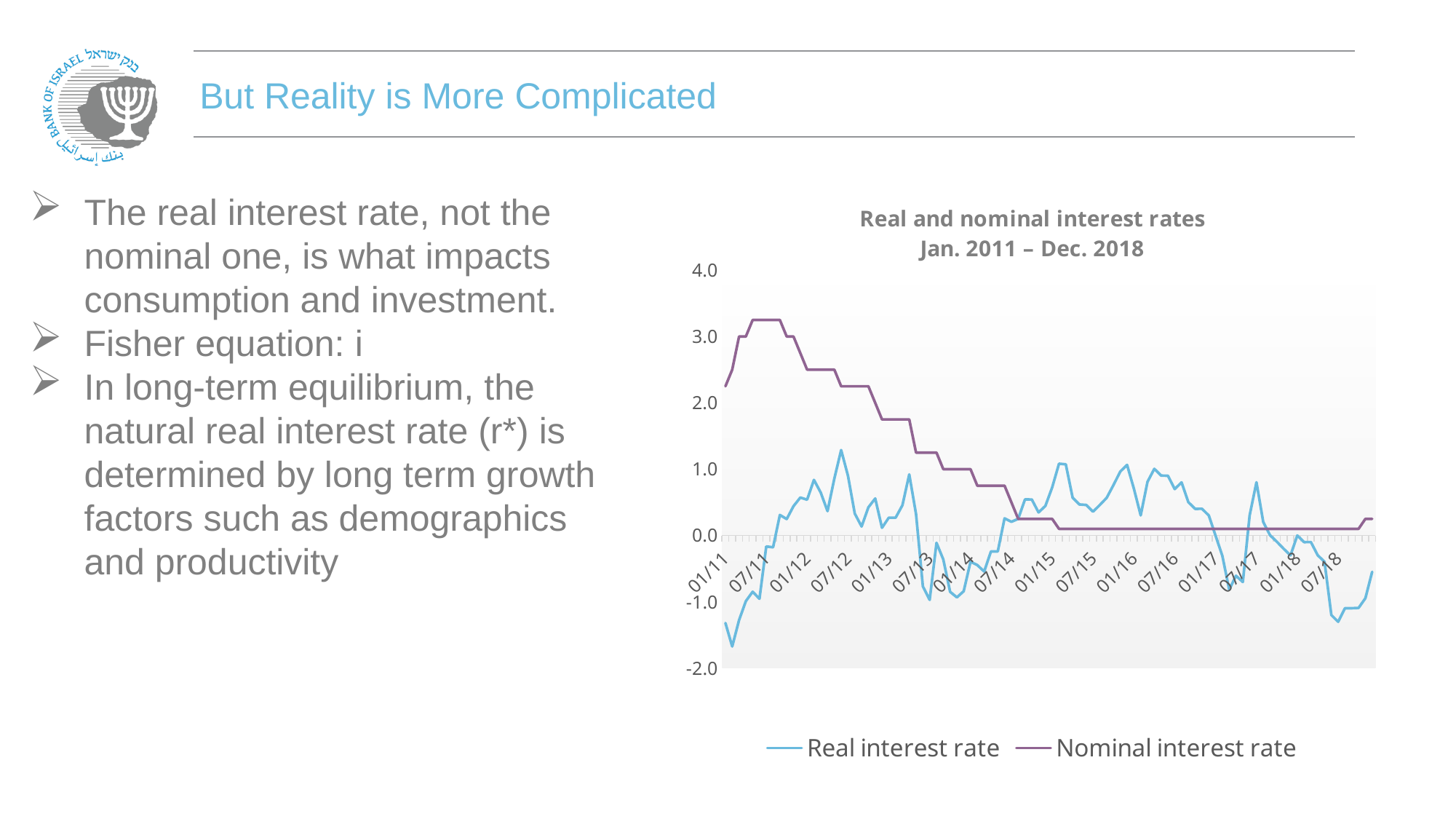
Does the Nominal interest rate generally rise or fall from 07/11 to 01/17? Fall Is the peak value of the Nominal interest rate greater or less than 3.0? greater What is the highest value shown on the vertical axis? 4.0 At 01/11, which series has the higher value, Real interest rate or Nominal interest rate? Nominal interest rate What type of chart is shown on the slide? Line chart Is the lowest value of the Real interest rate greater or less than -1.0? less Is the Real interest rate at 01/11 greater or less than -1.0? less How many series does the chart legend list? 2 What is the title of the chart? Real and nominal interest rates Jan. 2011 – Dec. 2018 Which colour is used for the Real interest rate line? Blue At 01/16, which series has the higher value, Real interest rate or Nominal interest rate? Real interest rate